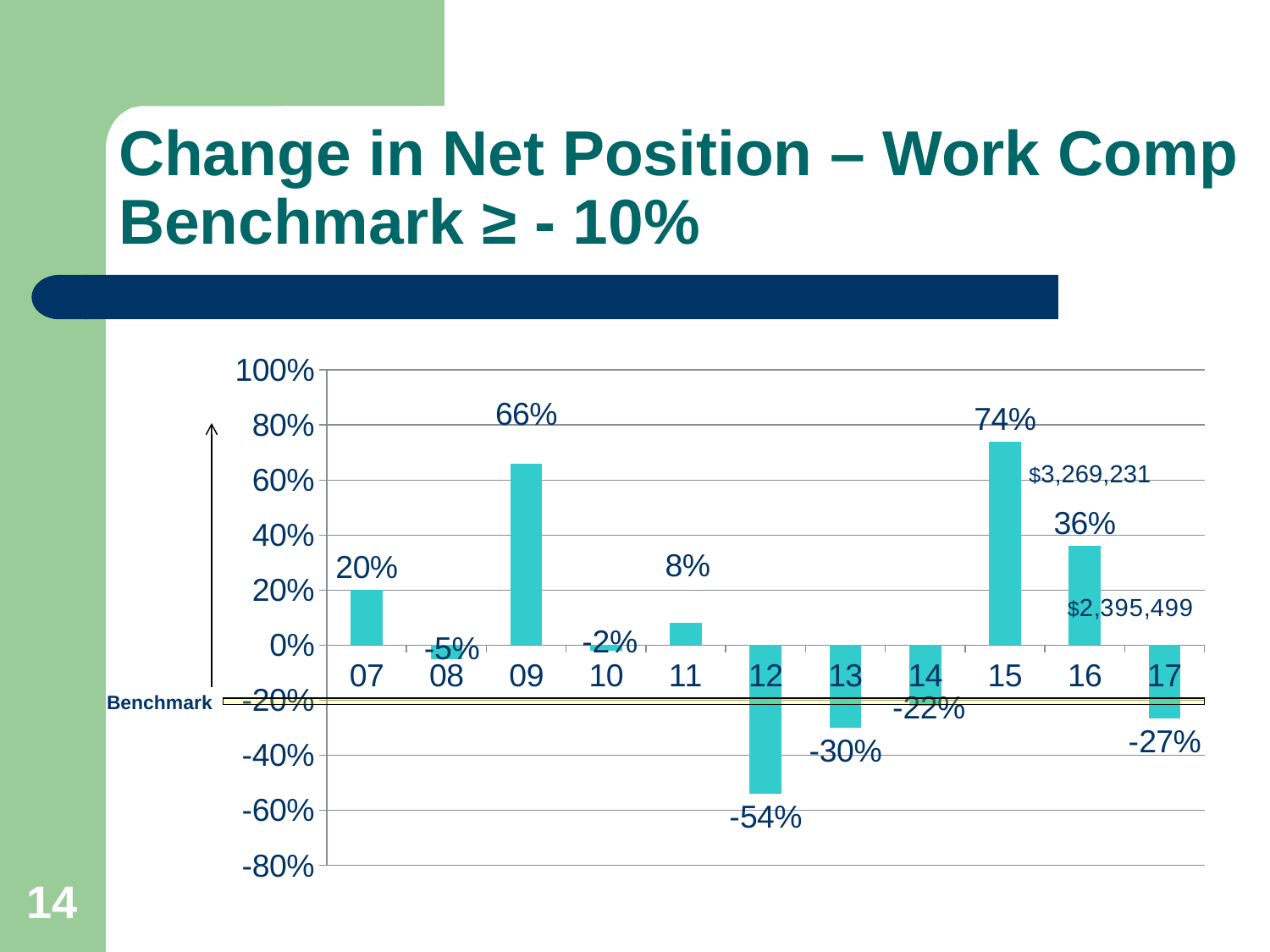
What kind of chart is this? bar chart What is the value for 09? 66% Is the value for 13 greater or less than -20%? less What is the title of the slide? Change in Net Position – Work Comp Benchmark ≥ - 10% What is the difference between the values for 15 and 16? 38% What dollar amount is annotated next to the bar for 15? $3,269,231 What is the value for 12? -54% What is the value for 17? -27% Which year has the highest value? 15 Which year has the lowest value? 12 Which is larger, the value for 07 or the value for 11? 07 How many years are shown on the x axis? 11